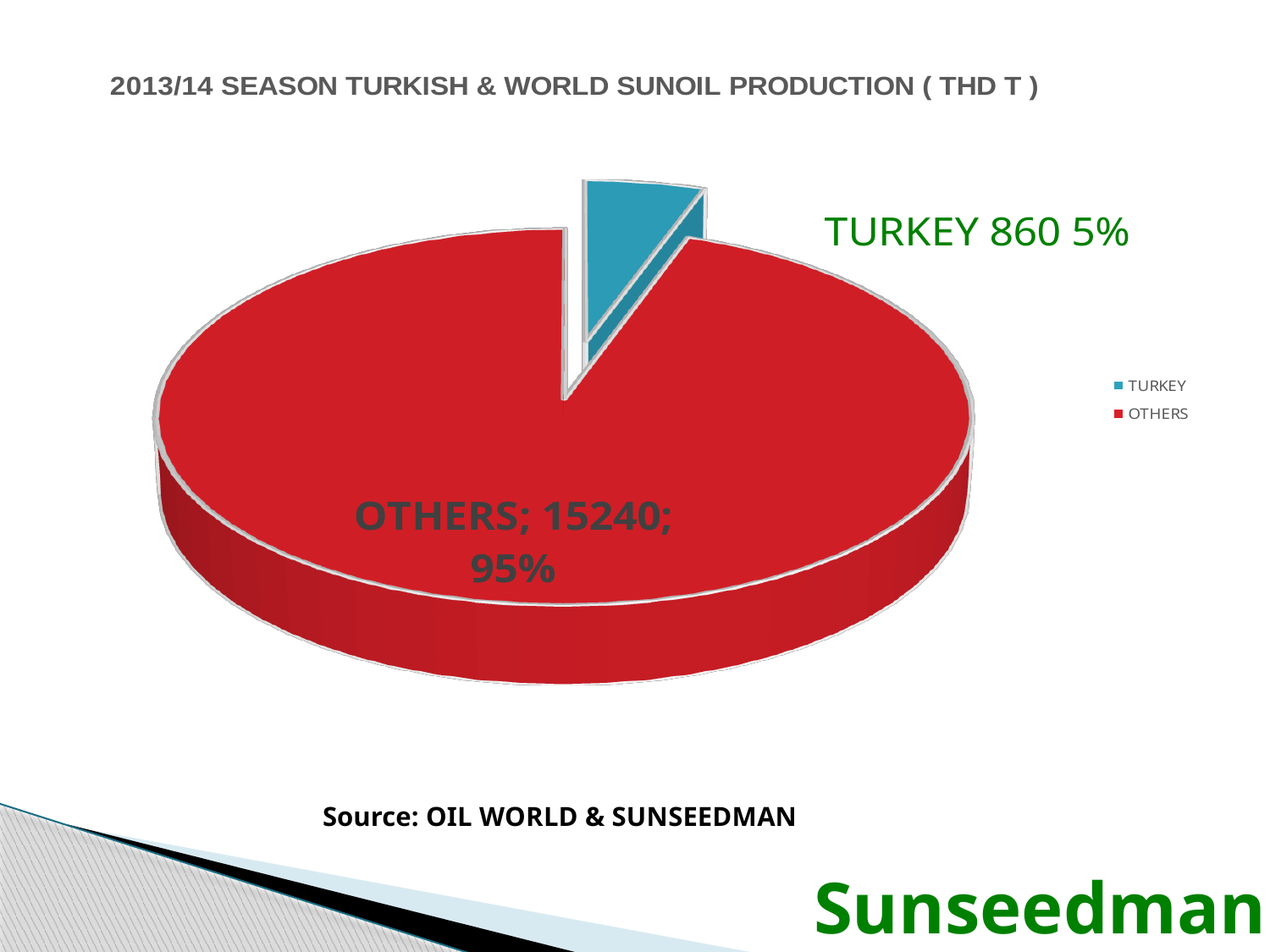
Which category has the smallest slice? TURKEY What is the value for TURKEY? 860 What share of the pie does OTHERS represent? 95% What is the title of the chart? 2013/14 SEASON TURKISH & WORLD SUNOIL PRODUCTION ( THD T ) Which is larger, the value for TURKEY or the value for OTHERS? OTHERS What is the value for OTHERS? 15240 What colour is the TURKEY slice? Blue What share of the pie does TURKEY represent? 5% What kind of chart is shown on the slide? Pie chart How many categories does the pie chart have? 2 What is the difference between the values for OTHERS and TURKEY? 14380 Which category has the largest slice? OTHERS